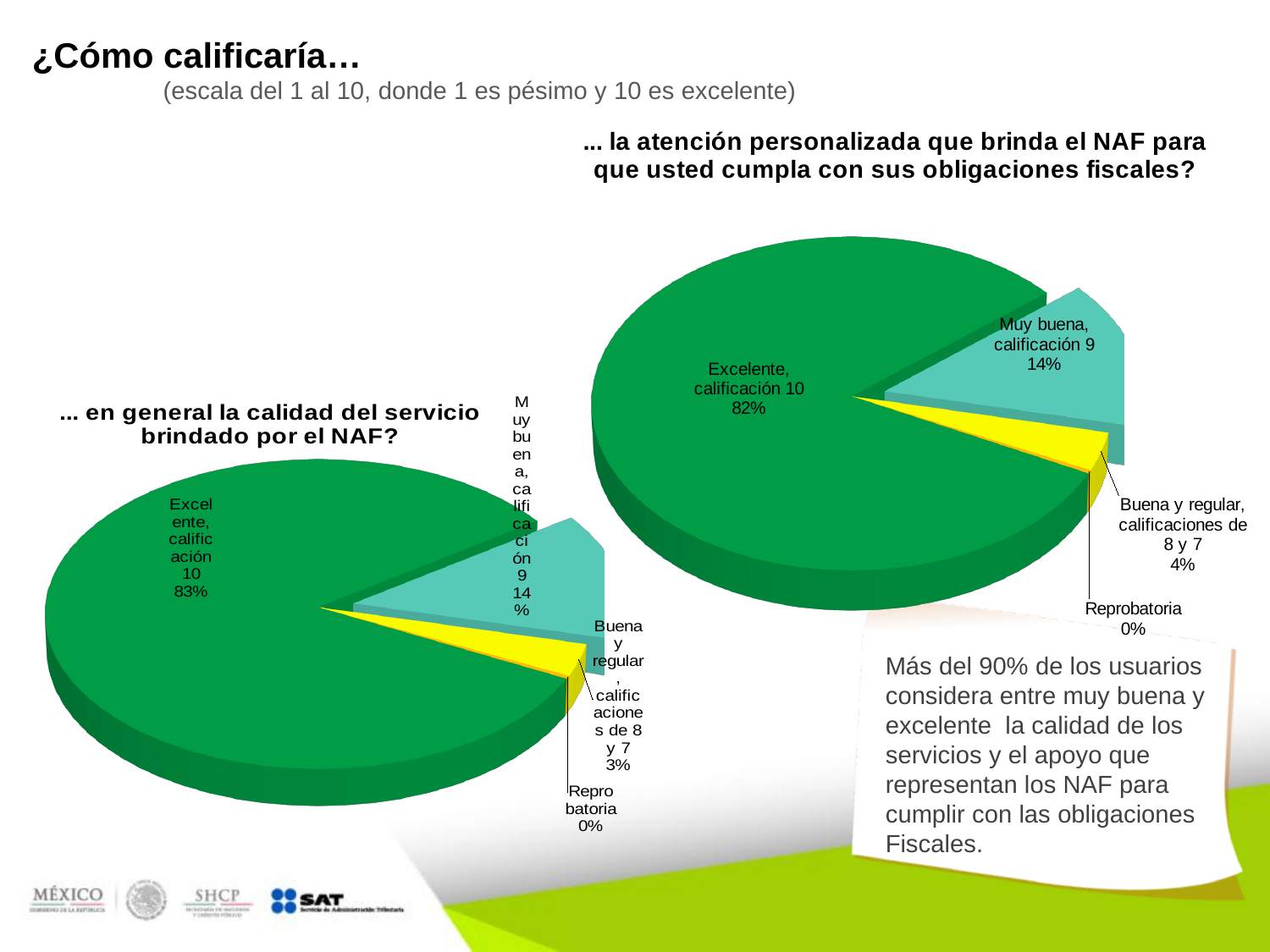
In the chart titled '... en general la calidad del servicio brindado por el NAF?', what share is labelled for 'Reprobatoria'? 0% In the chart titled '... en general la calidad del servicio brindado por el NAF?', which is larger: 'Muy buena, calificación 9' or 'Buena y regular, calificaciones de 8 y 7'? Muy buena, calificación 9 What type of chart is the one titled '... la atención personalizada que brinda el NAF para que usted cumpla con sus obligaciones fiscales?'? Pie chart In the chart titled '... en general la calidad del servicio brindado por el NAF?', what share is labelled for 'Buena y regular, calificaciones de 8 y 7'? 3% In the chart titled '... en general la calidad del servicio brindado por el NAF?', which category has the smallest slice? Reprobatoria In the chart titled '... en general la calidad del servicio brindado por el NAF?', what share is labelled for 'Excelente, calificación 10'? 83% In the chart titled '... la atención personalizada que brinda el NAF para que usted cumpla con sus obligaciones fiscales?', what share is labelled for 'Excelente, calificación 10'? 82% In the chart titled '... la atención personalizada que brinda el NAF para que usted cumpla con sus obligaciones fiscales?', what is the difference in percentage points between 'Excelente, calificación 10' and 'Muy buena, calificación 9'? 68 How many categories are shown in the chart titled '... en general la calidad del servicio brindado por el NAF?'? 4 In the chart titled '... la atención personalizada que brinda el NAF para que usted cumpla con sus obligaciones fiscales?', what share is labelled for 'Muy buena, calificación 9'? 14% In the chart titled '... la atención personalizada que brinda el NAF para que usted cumpla con sus obligaciones fiscales?', which category has the largest slice? Excelente, calificación 10 In the chart titled '... la atención personalizada que brinda el NAF para que usted cumpla con sus obligaciones fiscales?', what share is labelled for 'Buena y regular, calificaciones de 8 y 7'? 4%